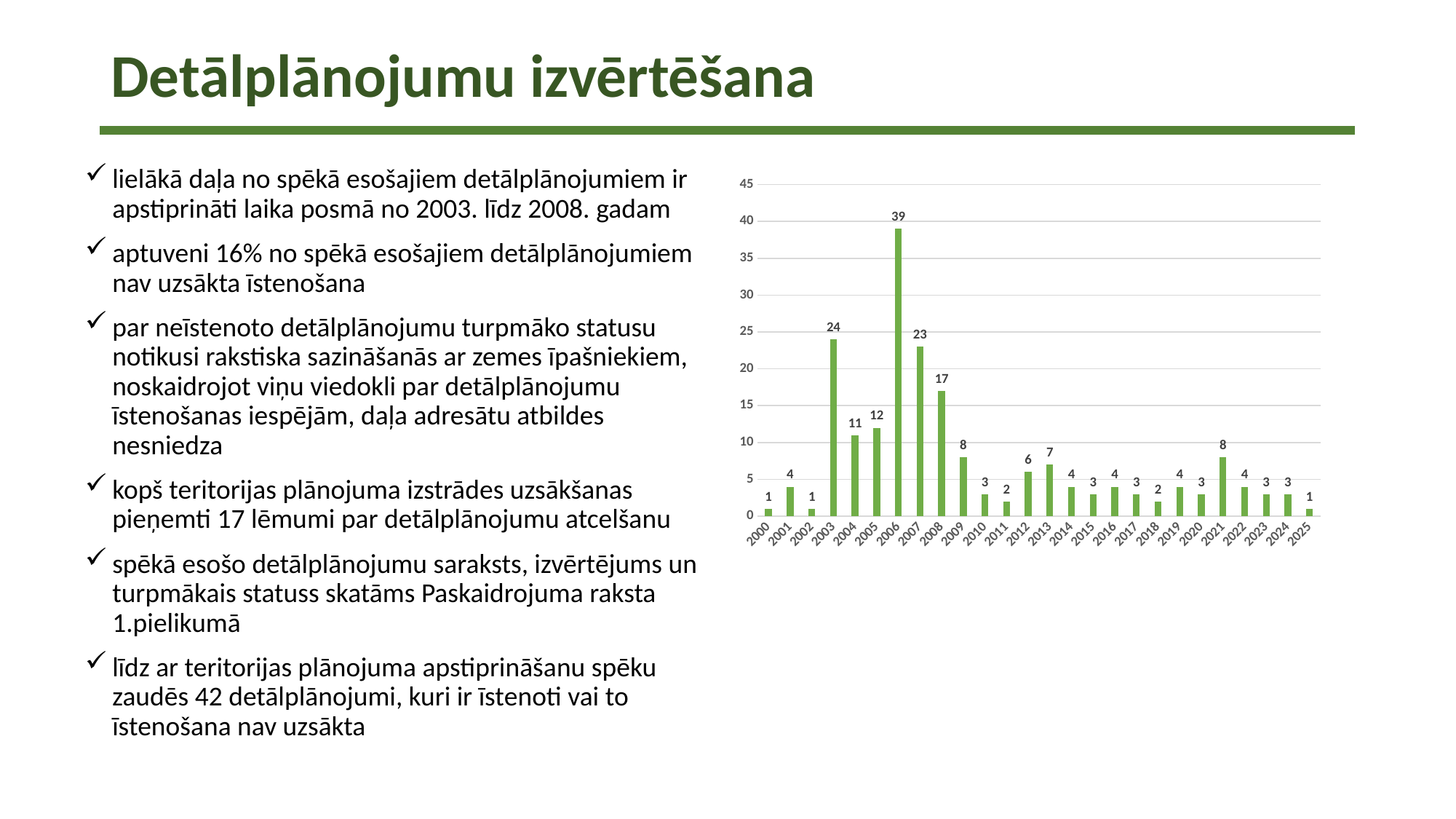
How many years are shown on the x axis? 26 Which year has the highest value? 2006 Is the value for 2006 greater or less than 35? greater What is the value for 2006? 39 Which is larger, the value for 2009 or the value for 2021? They are equal (8) What kind of chart is shown on the slide? bar chart What is the difference between the values for 2003 and 2008? 7 What is the difference between the values for 2006 and 2007? 16 Do the values rise or fall from 2006 to 2011? fall Which is larger, the value for 2004 or the value for 2005? 2005 What is the value for 2013? 7 What is the value for 2003? 24